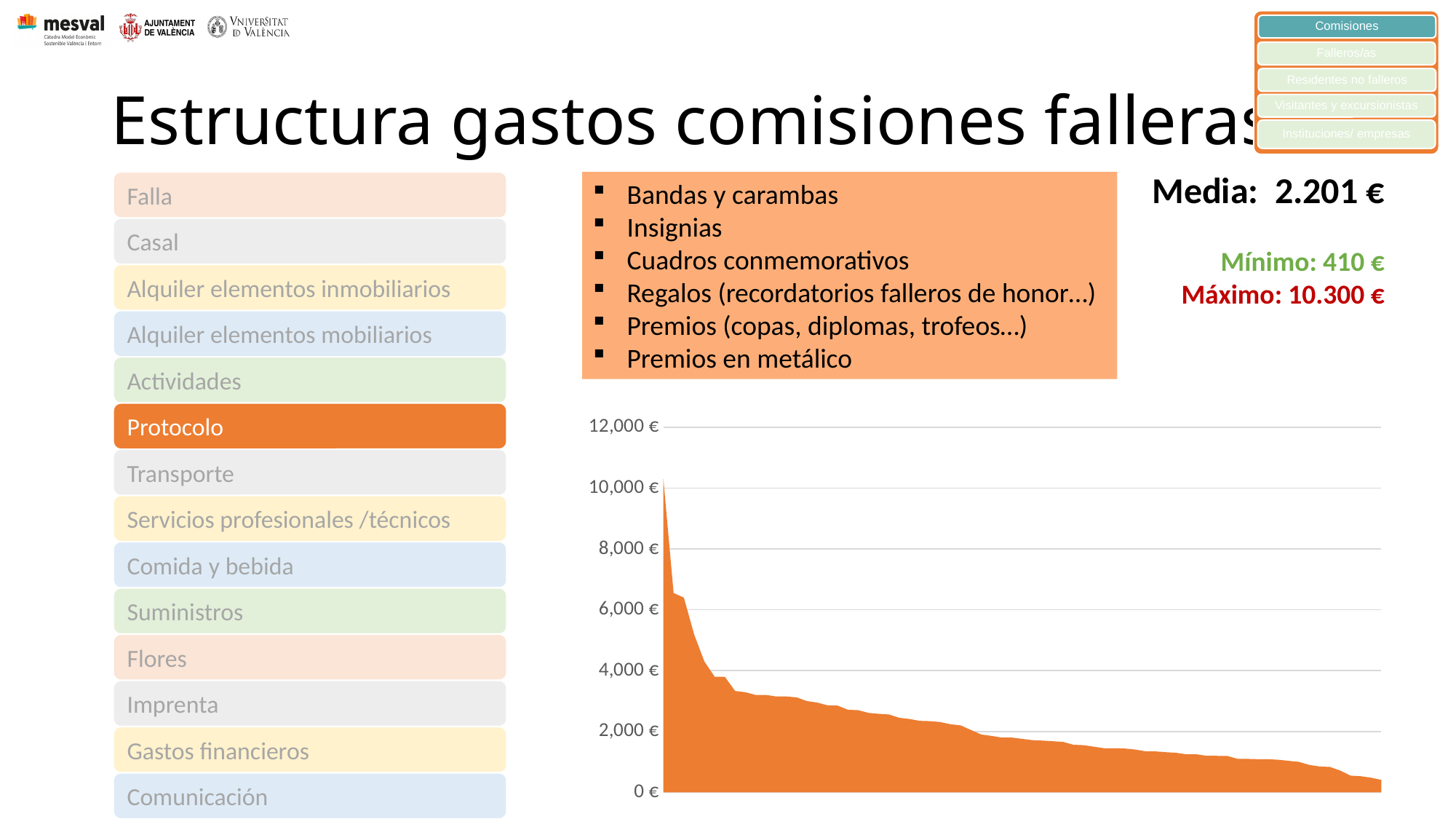
Is the value at the right end of the chart greater or less than 1,000 €? less Is the highest value in the chart greater or less than 8,000 €? greater Is the value at the left end of the chart larger or smaller than the value at the right end? larger What kind of chart is shown on the slide? area chart Do the values in the chart rise or fall from left to right? fall According to the slide, what is the maximum value of the plotted protocol expenses? 10.300 € Which expense category in the left-hand list is highlighted as the one the chart refers to? Protocolo What is the highest tick value shown on the vertical axis of the chart? 12,000 € Is the lowest value at the right end of the chart greater or less than 2,000 €? less How many tick labels are shown on the vertical axis of the chart? 7 According to the slide, what is the minimum value of the plotted protocol expenses? 410 € According to the slide, what is the mean (Media) of the plotted protocol expenses? 2.201 €